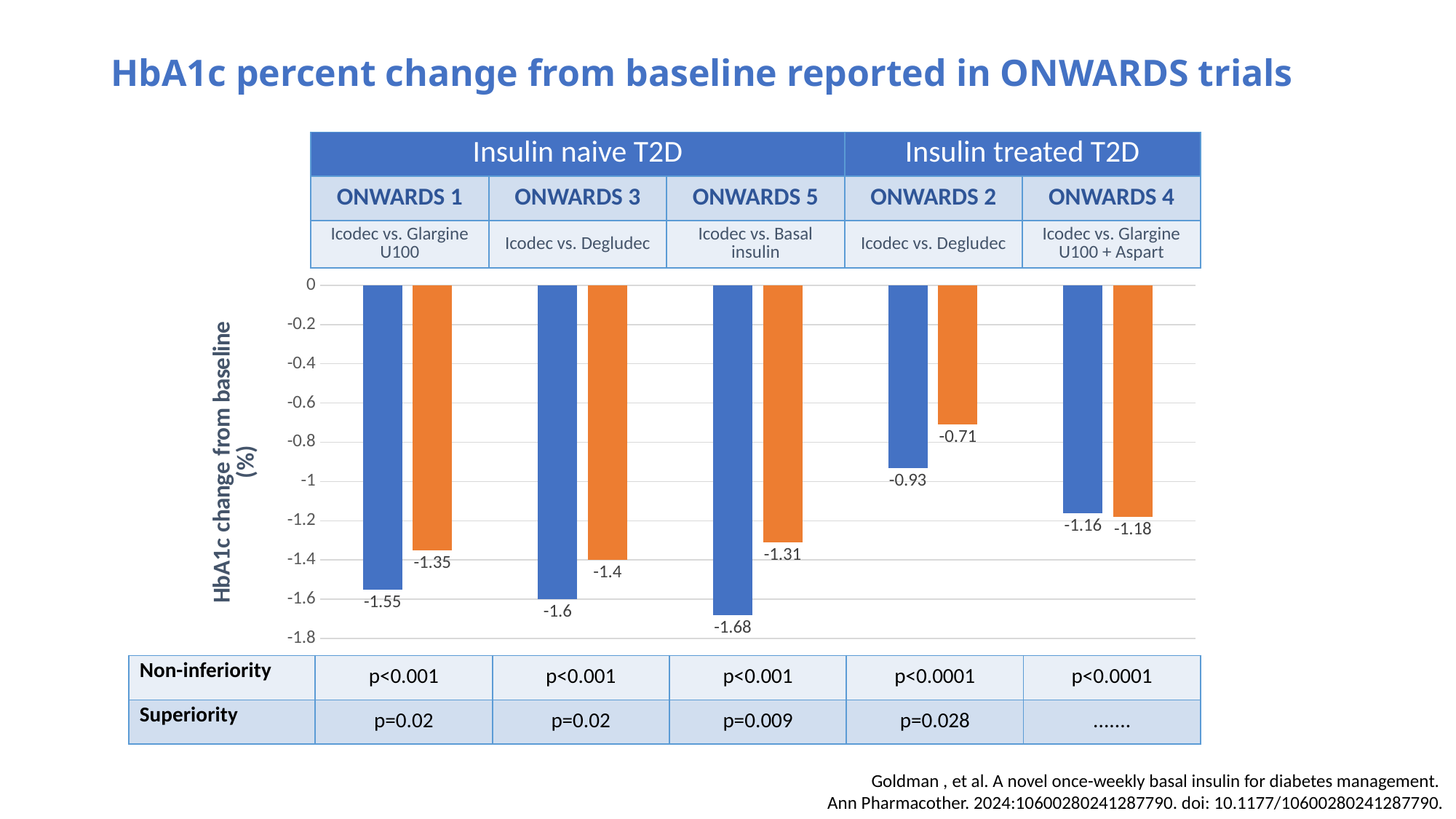
What is the value of the orange bar for ONWARDS 4? -1.18 Which bar shows a larger HbA1c reduction in ONWARDS 5, the blue bar or the orange bar? blue bar Which trial has the largest HbA1c reduction (most negative blue bar)? ONWARDS 5 What is the value of the blue bar for ONWARDS 5? -1.68 How many trials (category groups) are plotted on the chart? 5 What is the value of the orange bar for ONWARDS 3? -1.4 What type of chart is shown on the slide? bar chart What is the label of the vertical axis? HbA1c change from baseline (%) What is the difference between the blue and orange bar values for ONWARDS 1? 0.2 What is the value of the orange bar for ONWARDS 2? -0.71 What is the value of the blue bar for ONWARDS 1? -1.55 Which trial has the smallest HbA1c reduction (least negative orange bar)? ONWARDS 2